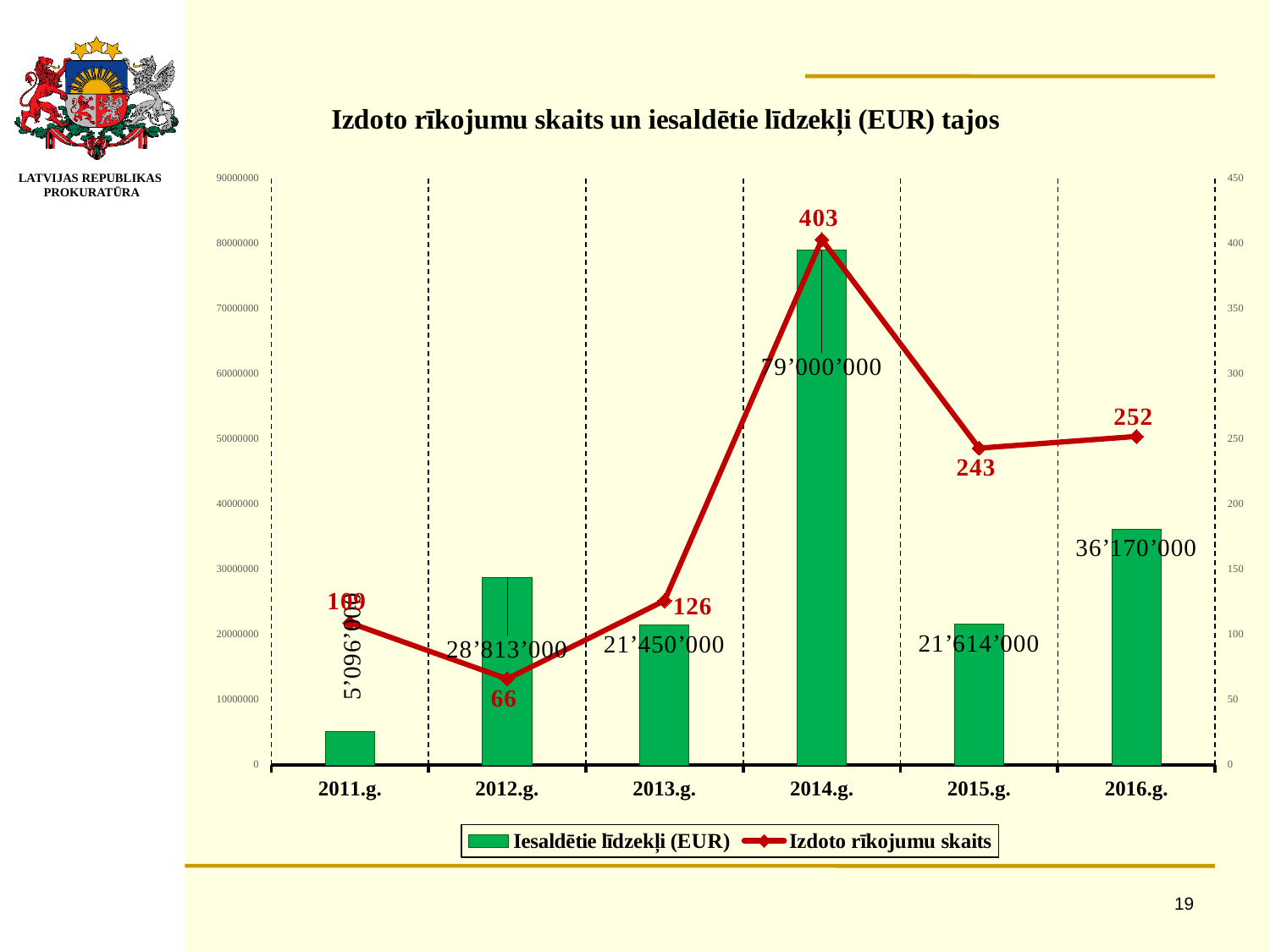
What is the difference in Izdoto rīkojumu skaits between 2016.g. and 2015.g.? 9 What is the Izdoto rīkojumu skaits value for 2012.g.? 66 How many years are shown on the x axis? 6 What is the difference in Izdoto rīkojumu skaits between 2014.g. and 2013.g.? 277 What is the value of Iesaldētie līdzekļi (EUR) for 2015.g.? 21'614'000 What kind of chart is shown on the slide? Combination bar and line chart In which year is Izdoto rīkojumu skaits the highest? 2014.g. What is the value of Iesaldētie līdzekļi (EUR) for 2014.g.? 79'000'000 Which year has the larger Iesaldētie līdzekļi (EUR) value, 2012.g. or 2013.g.? 2012.g. How many series does the legend list? 2 What is the value of Iesaldētie līdzekļi (EUR) for 2016.g.? 36'170'000 In which year is Iesaldētie līdzekļi (EUR) the lowest? 2011.g.